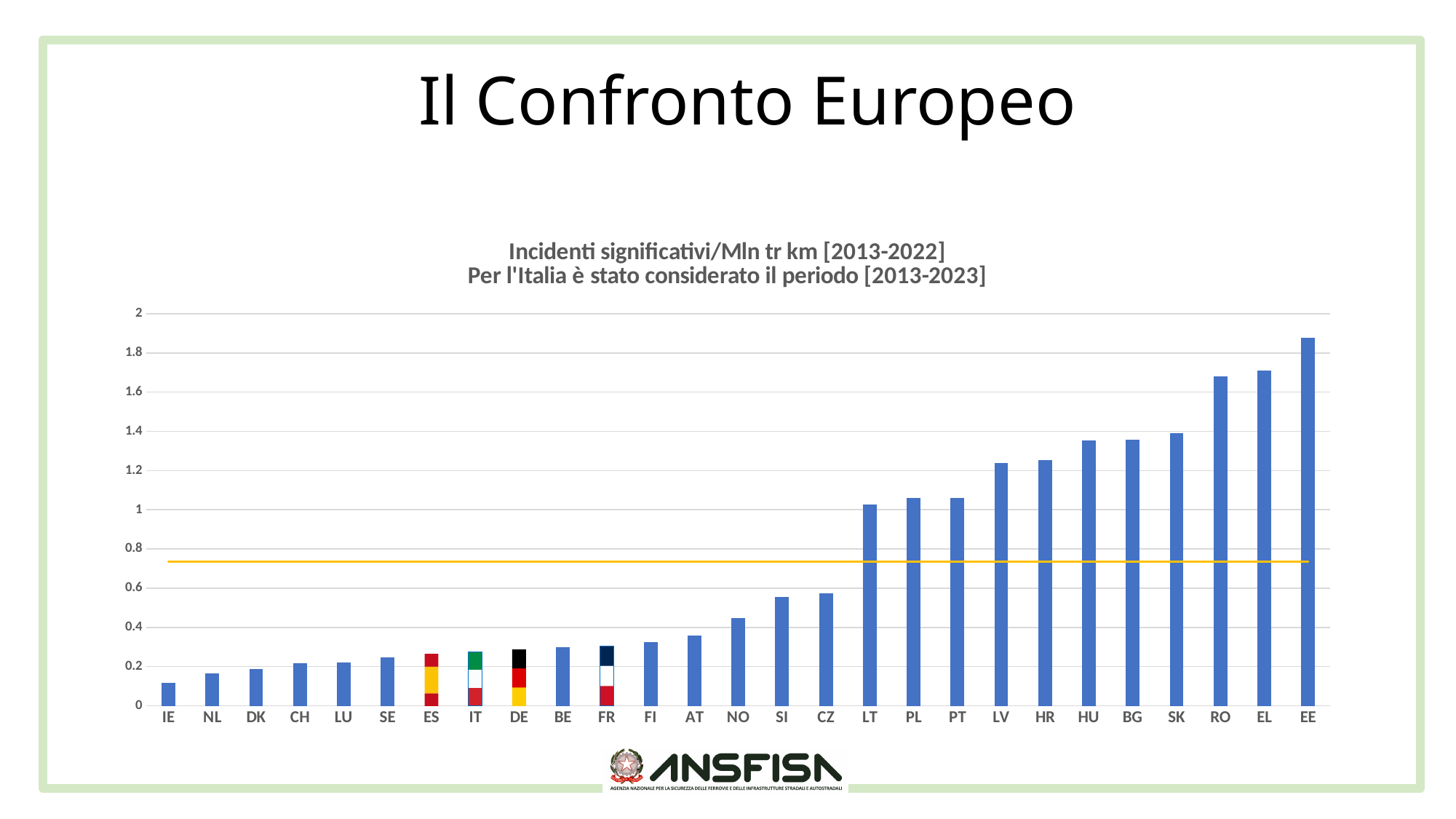
Do the values rise or fall moving from left to right along the x axis? rise Which four countries' bars are drawn in their national flag colours instead of blue? ES, IT, DE, FR Which has the larger value, RO or EE? EE Is the value for LT greater or less than 1? greater How many countries are plotted on the chart? 27 Which country has the highest value on the chart? EE Is the value for EE greater or less than 1.8? greater Which country has the lowest value on the chart? IE Which has the larger value, CZ or LT? LT Is the value for CZ greater or less than 0.6? less What kind of chart is shown on the slide? bar chart